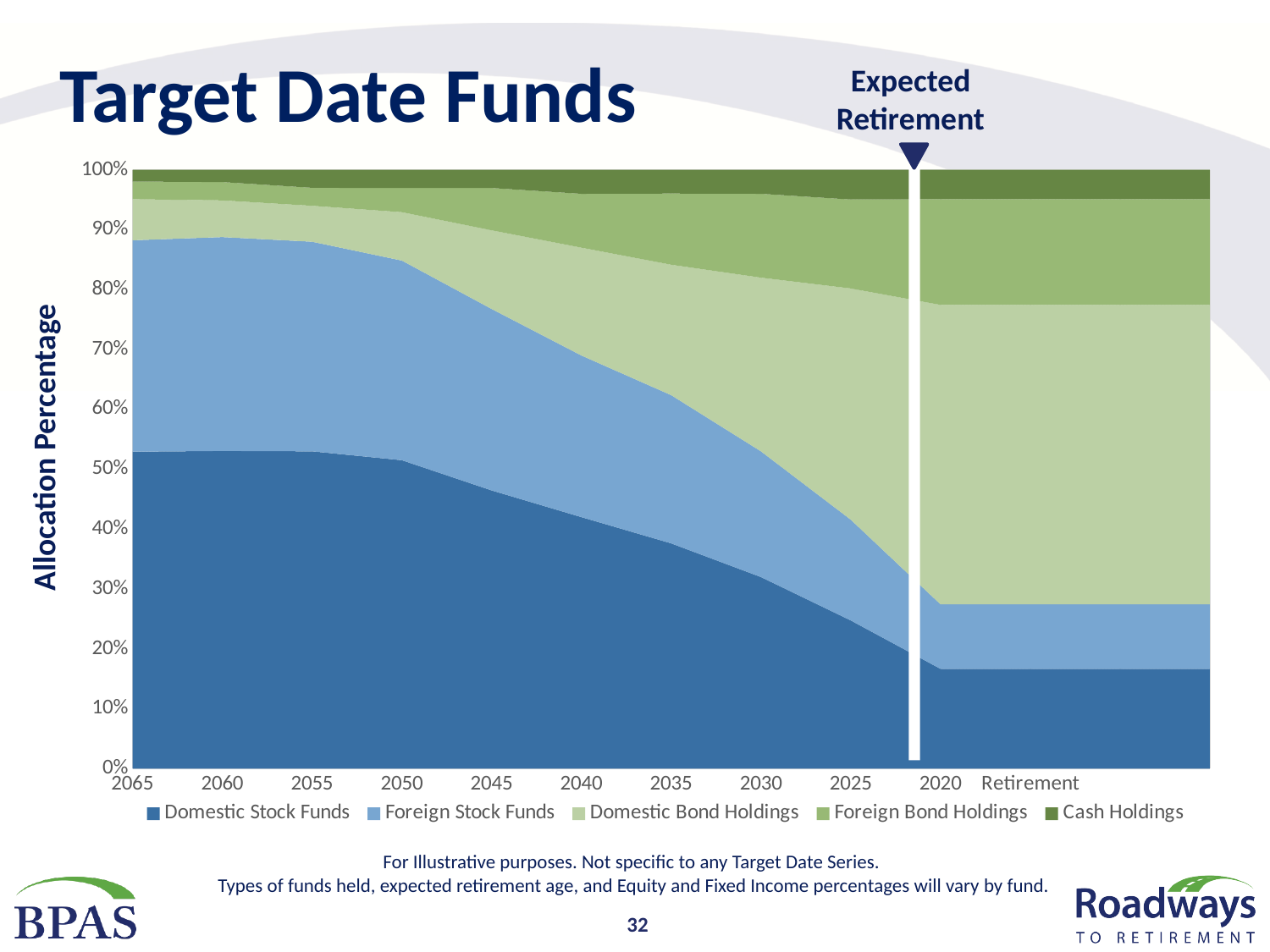
How many series does the legend list? 5 Is the Domestic Stock Funds allocation at Retirement greater or less than 20%? less What event does the vertical white line with the triangle marker indicate? Expected Retirement What kind of chart is shown on the slide? Stacked area chart Does the Domestic Bond Holdings allocation rise or fall from 2065 to Retirement? Rise At 2065, which is larger: Domestic Stock Funds or Foreign Stock Funds? Domestic Stock Funds Is the Domestic Stock Funds allocation at 2065 greater or less than 40%? greater Does the Domestic Stock Funds allocation rise or fall from 2065 to Retirement? Fall How many labels are shown along the x axis? 11 What is the label on the y axis? Allocation Percentage At Retirement, which series has the largest allocation? Domestic Bond Holdings Is the Domestic Stock Funds allocation at 2030 greater or less than 40%? less